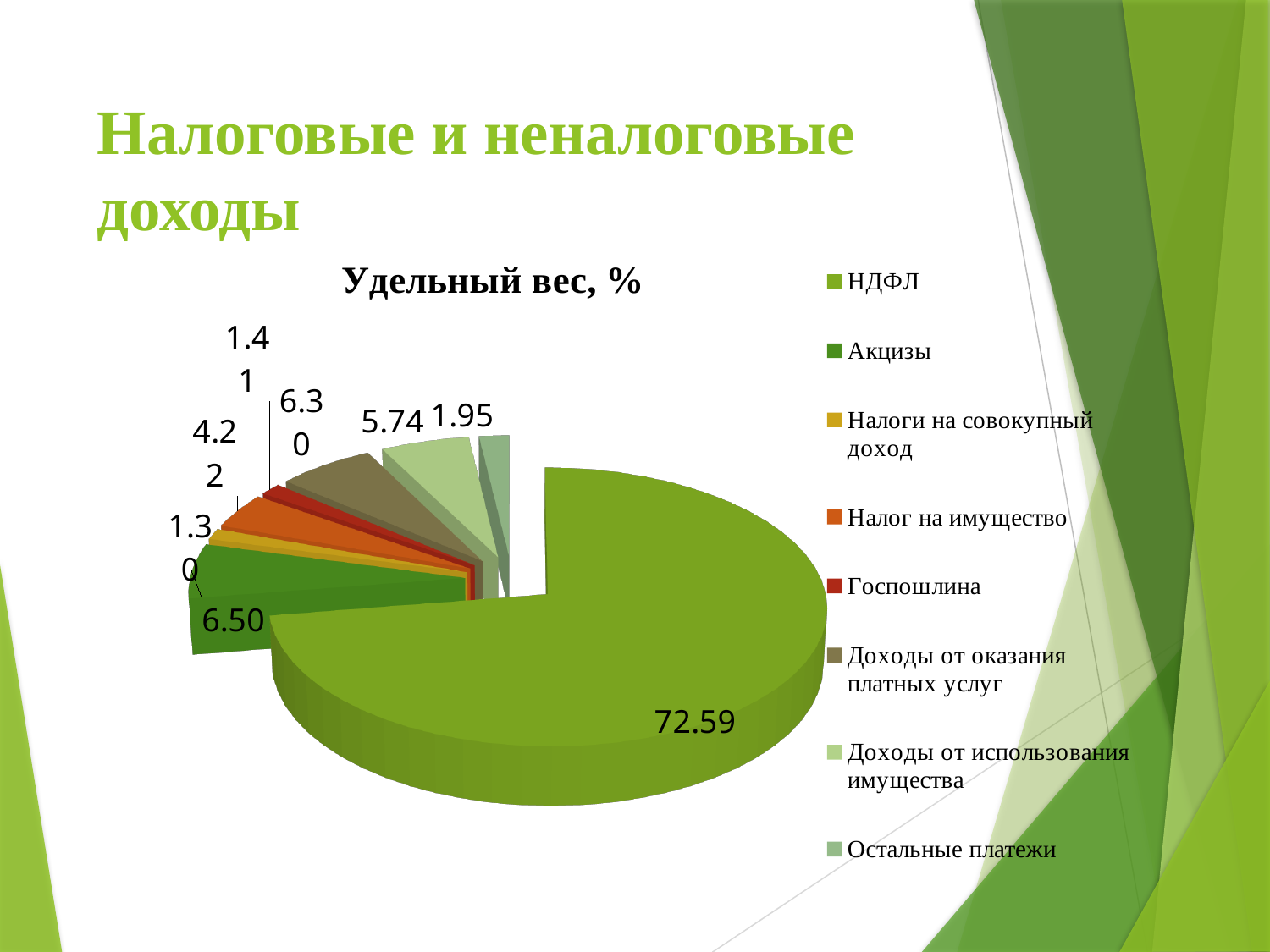
What type of chart is shown on the slide? Pie chart Which category has the largest share of the pie? НДФЛ What is the value shown for Доходы от использования имущества? 5.74 What is the value shown for Акцизы? 6.50 What is the value shown for Остальные платежи? 1.95 What is the value shown for Налог на имущество? 4.22 What is the value shown for НДФЛ? 72.59 What is the difference between the values for НДФЛ and Акцизы? 66.09 Which category has the smallest share of the pie? Налоги на совокупный доход Which is larger, the value for Акцизы or the value for Доходы от использования имущества? Акцизы What is the title of the chart? Удельный вес, % How many categories does the legend list? 8